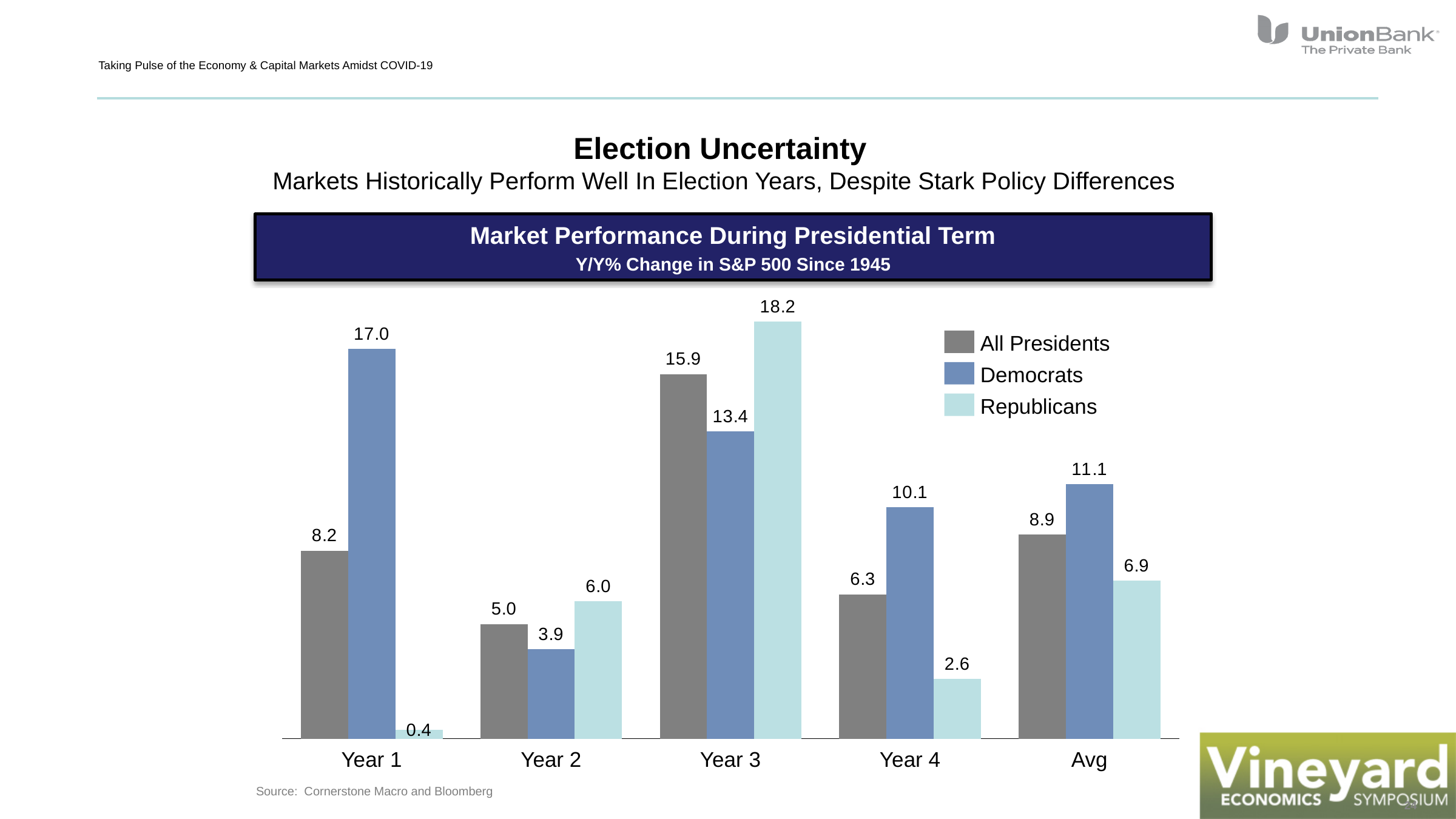
What is the difference between the Democrats and Republicans values in Year 1? 16.6 How many series does the legend list? 3 In which year is the Democrats value lowest? Year 2 What kind of chart is shown? Bar chart What is the value for All Presidents in Year 3? 15.9 What is the value for Democrats in Year 1? 17.0 What is the Avg value for Republicans? 6.9 Which is larger in Year 2: the All Presidents value or the Republicans value? Republicans How many categories are shown on the x axis? 5 What is the subtitle of the chart? Y/Y% Change in S&P 500 Since 1945 In which year is the Republicans value highest? Year 3 What is the value for Republicans in Year 4? 2.6